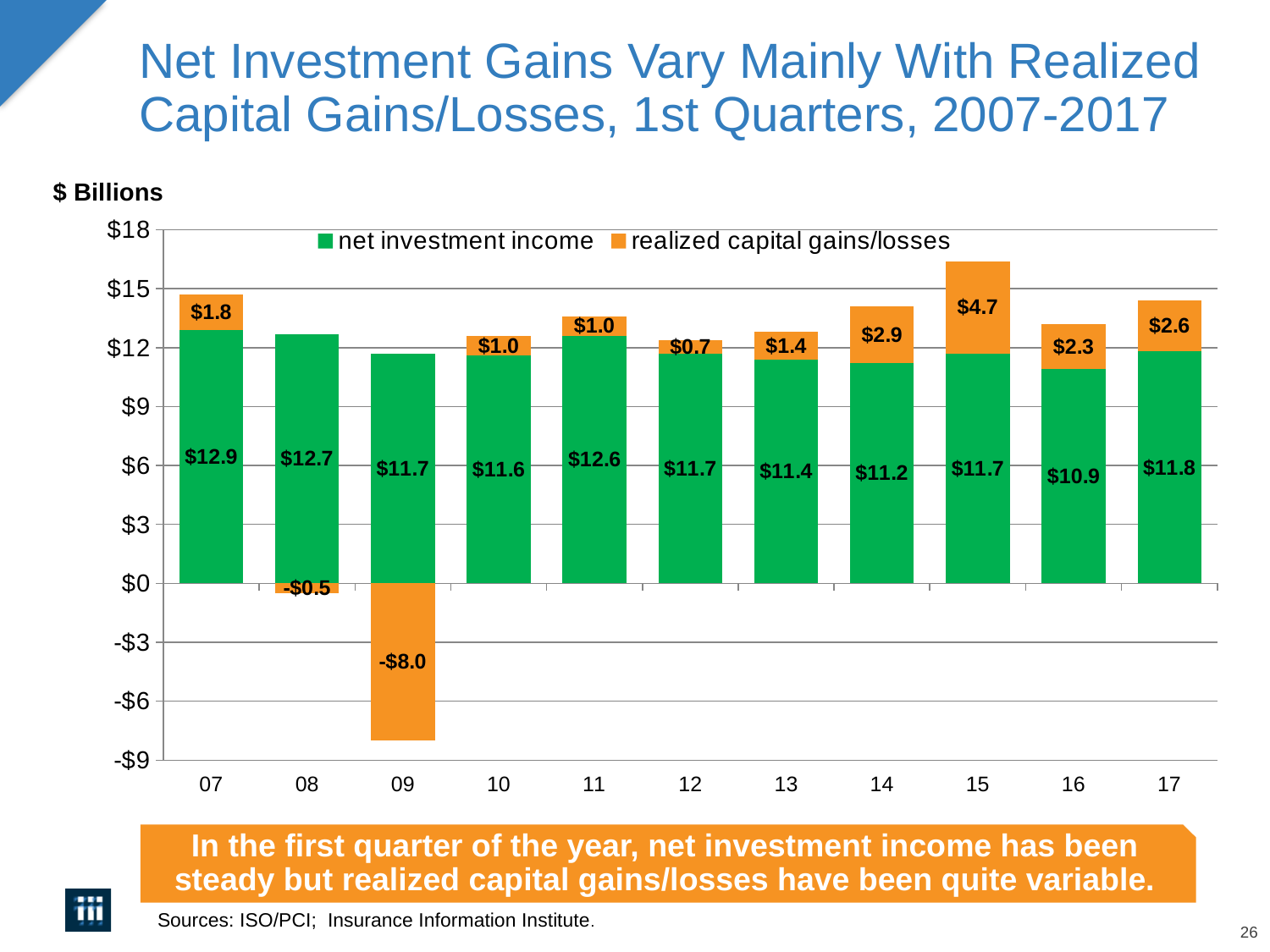
Which year had the lowest realized capital gains/losses? 09 Which year had the highest first-quarter net investment income? 07 How many series does the legend list? 2 What was net investment income in the first quarter of 2007? $12.9 What were realized capital gains/losses in the first quarter of 2009? -$8.0 What kind of chart is shown on the slide? Stacked bar chart Were realized capital gains/losses larger in 2014 or in 2015? 2015 Which year had the lowest first-quarter net investment income? 16 What is the difference between net investment income in 2007 and in 2016? $2.0 What is the total of the stacked bar for 2015 (net investment income plus realized capital gains/losses)? $16.4 What were realized capital gains/losses in the first quarter of 2015? $4.7 How many years are shown on the x axis? 11